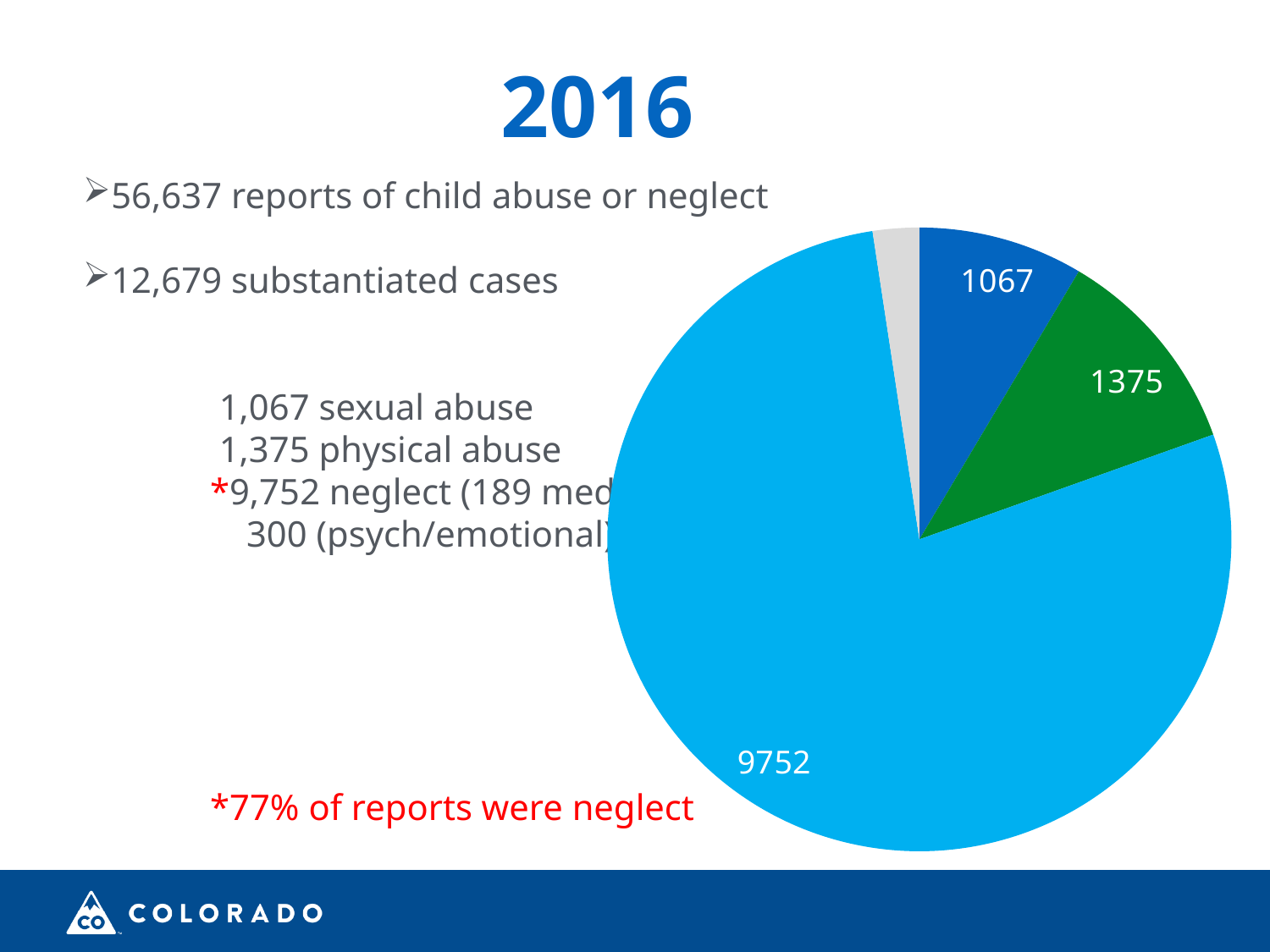
What colour is the largest slice of the pie chart? light blue According to the slide, what percentage of reports were neglect? 77% What value is labeled on the dark blue slice of the pie chart? 1067 Which slice is larger, the one labeled 1375 or the one labeled 1067? 1375 What year is shown as the title of the slide? 2016 How many slices of the pie chart have a printed data label? 3 What value is labeled on the green slice of the pie chart? 1375 What is the difference between the slice labeled 1375 and the slice labeled 1067? 308 Which labeled value corresponds to the largest slice of the pie chart? 9752 What type of chart is shown on the slide? pie chart What value is labeled on the largest slice of the pie chart? 9752 How many slices does the pie chart have? 4